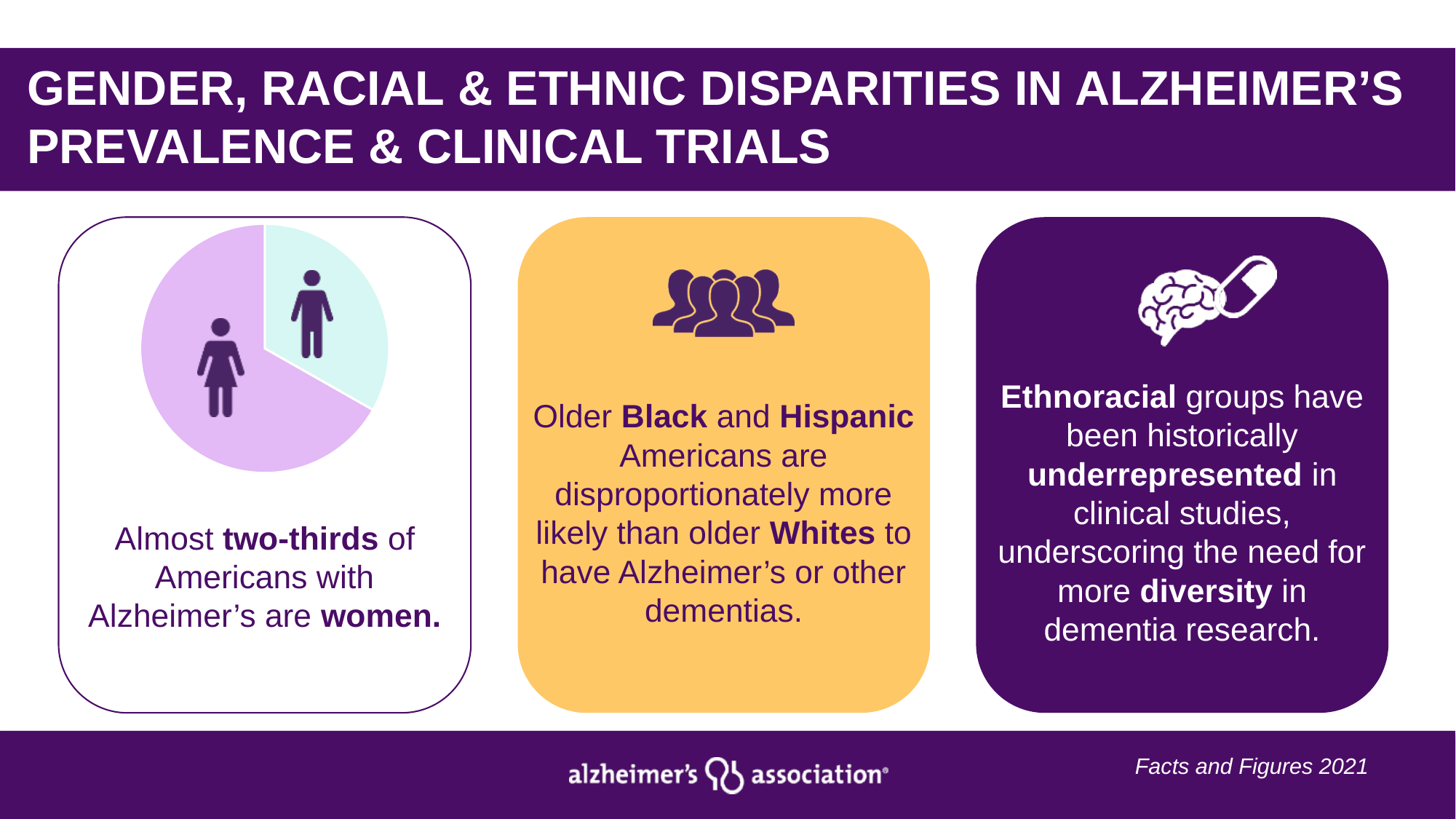
How many slices does the pie chart in the left panel have? 2 What colour is the smaller (men) slice of the pie chart? Light blue Is the women's slice of the pie chart greater or less than half of the pie? greater What colour is the larger (women) slice of the pie chart? Purple In the pie chart, which group has the larger slice, women or men? Women According to the slide text accompanying the pie chart, what share of Americans with Alzheimer's are women? Almost two-thirds In the pie chart, which group has the smaller slice? Men Is the men's slice of the pie chart greater or less than half of the pie? less What kind of chart is shown in the left panel of the slide? Pie chart